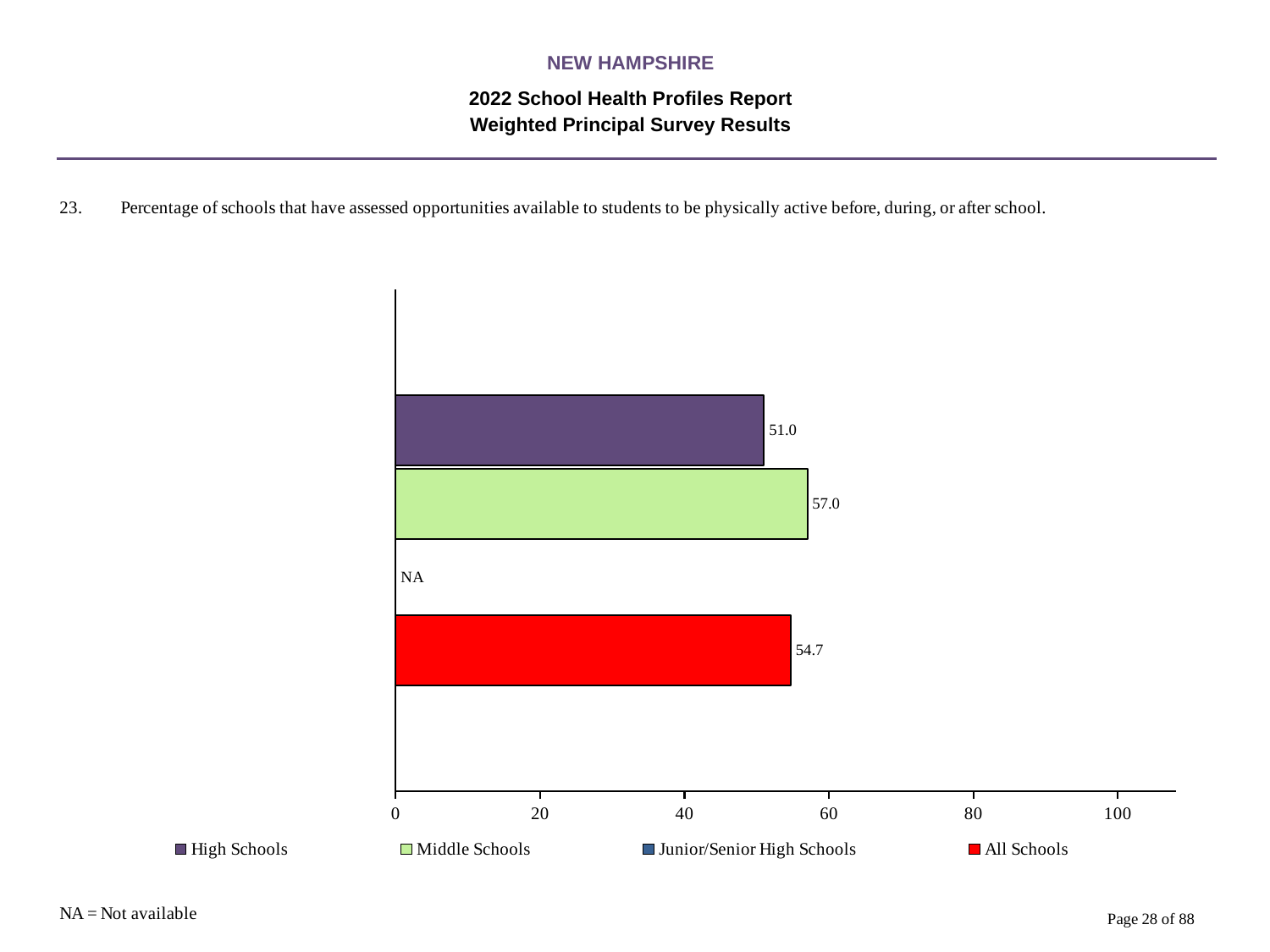
What is shown for Junior/Senior High Schools? NA Which school type with a plotted bar has the lowest value? High Schools Is the value for Middle Schools greater or less than 60? less What is the value for Middle Schools? 57.0 What kind of chart is shown? bar chart How many series does the legend list? 4 What colour is the All Schools bar? red Which is larger, the value for All Schools or the value for High Schools? All Schools Which school type has the highest value? Middle Schools What is the value for High Schools? 51.0 What is the difference between the Middle Schools value and the High Schools value? 6.0 What is the value for All Schools? 54.7